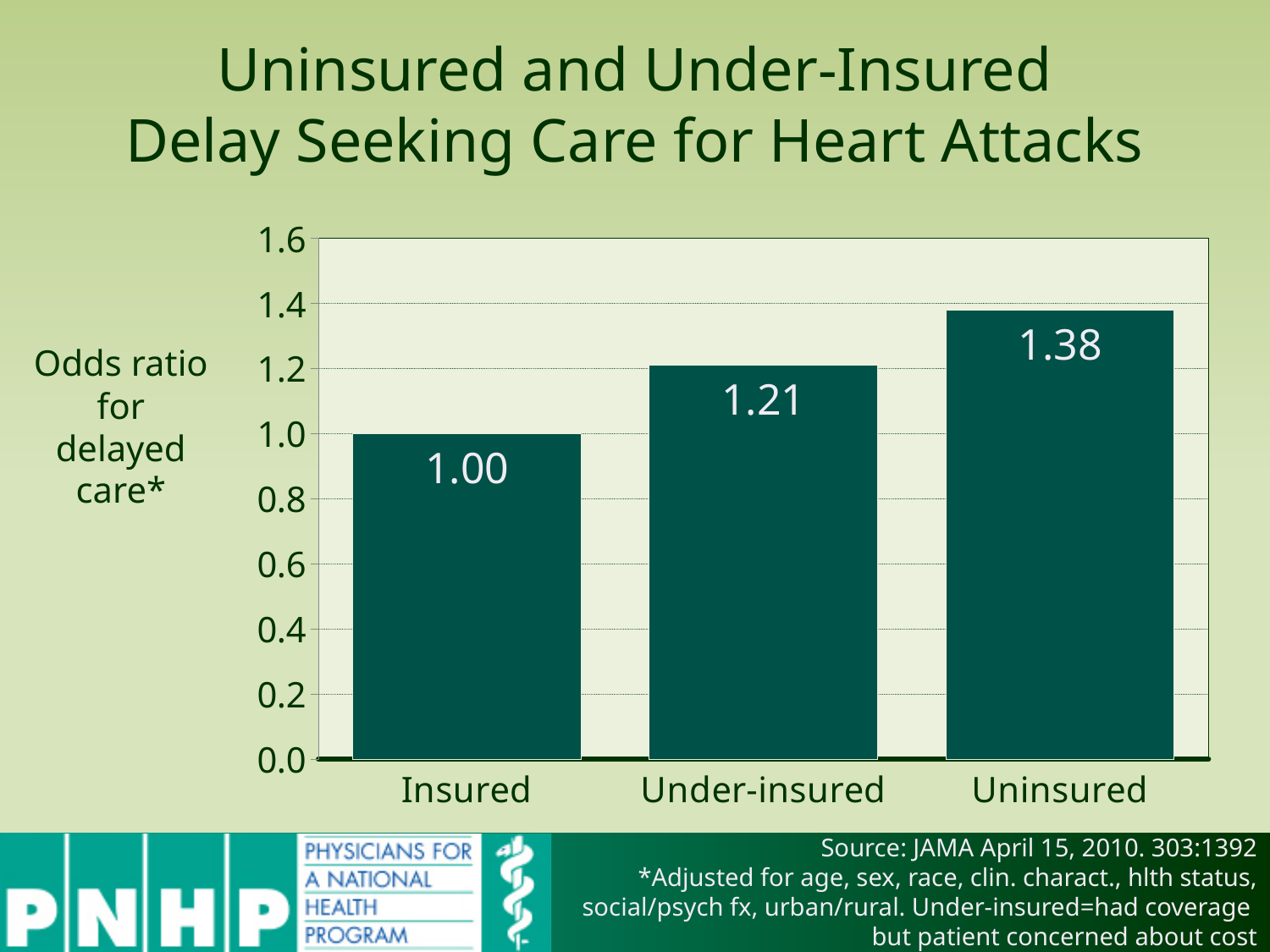
What kind of chart is shown on the slide? Bar chart How many groups are shown on the chart? 3 What is the odds ratio for delayed care for the Under-insured group? 1.21 Is the odds ratio for the Uninsured group greater or less than 1.2? greater What is the difference between the odds ratios for the Uninsured and Insured groups? 0.38 Which group has the highest odds ratio for delayed care? Uninsured Do the odds ratios rise or fall moving from Insured to Uninsured along the x axis? Rise Which group has the lowest odds ratio for delayed care? Insured What is the odds ratio for delayed care for the Insured group? 1.00 What is the odds ratio for delayed care for the Uninsured group? 1.38 Which group has a larger odds ratio for delayed care, Under-insured or Insured? Under-insured What is the difference between the odds ratios for the Uninsured and Under-insured groups? 0.17